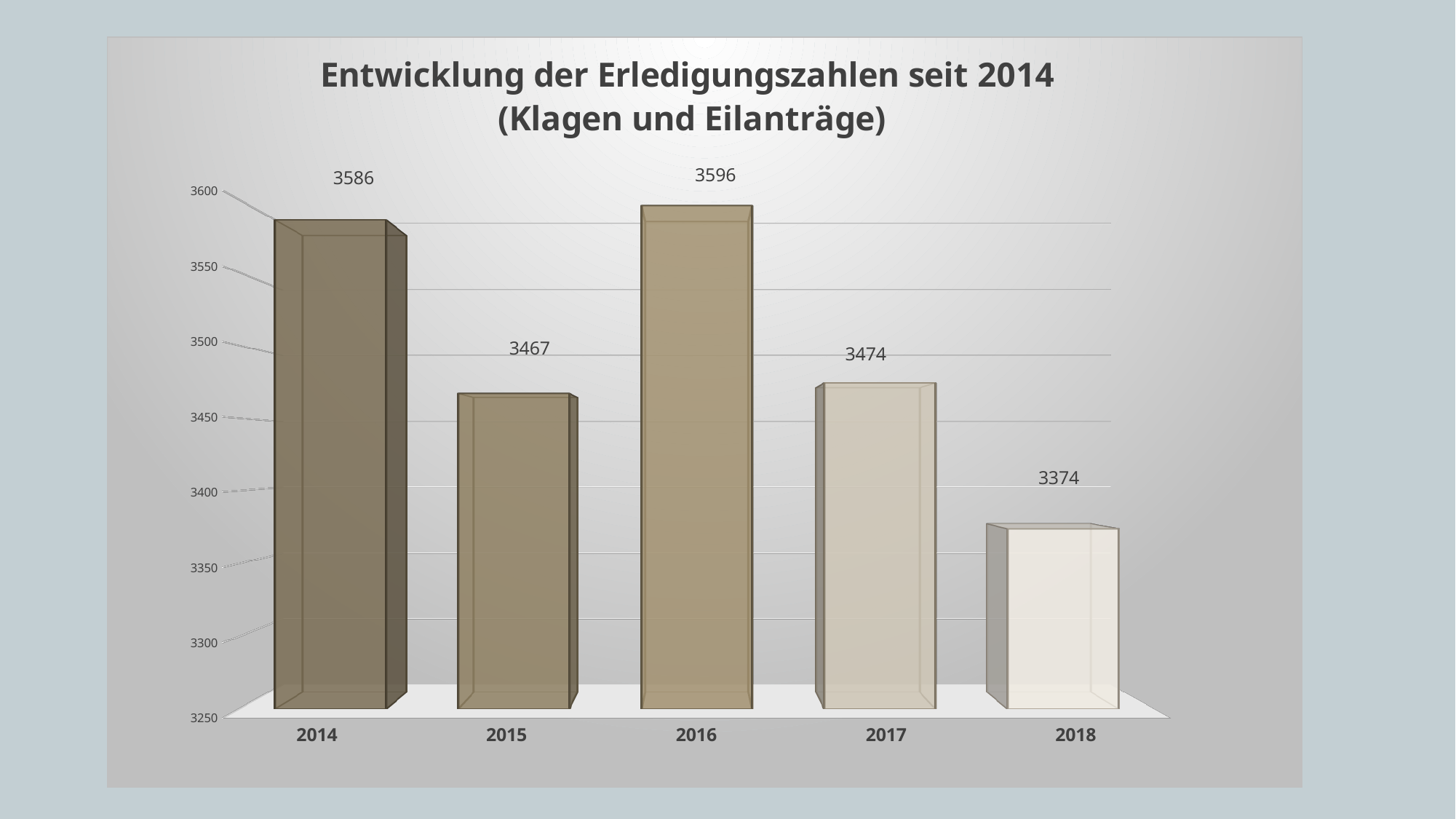
Which year has the highest value? 2016 What is the value for 2014? 3586 What is the difference between the values for 2016 and 2018? 222 Which year has the lowest value? 2018 What is the value for 2016? 3596 Is the value for 2017 greater or less than 3500? less What is the title of the chart? Entwicklung der Erledigungszahlen seit 2014 (Klagen und Eilanträge) How many years are shown on the x axis? 5 What is the value for 2018? 3374 What is the difference between the values for 2014 and 2015? 119 Which is larger, the value for 2015 or the value for 2017? 2017 What kind of chart is shown on the slide? bar chart